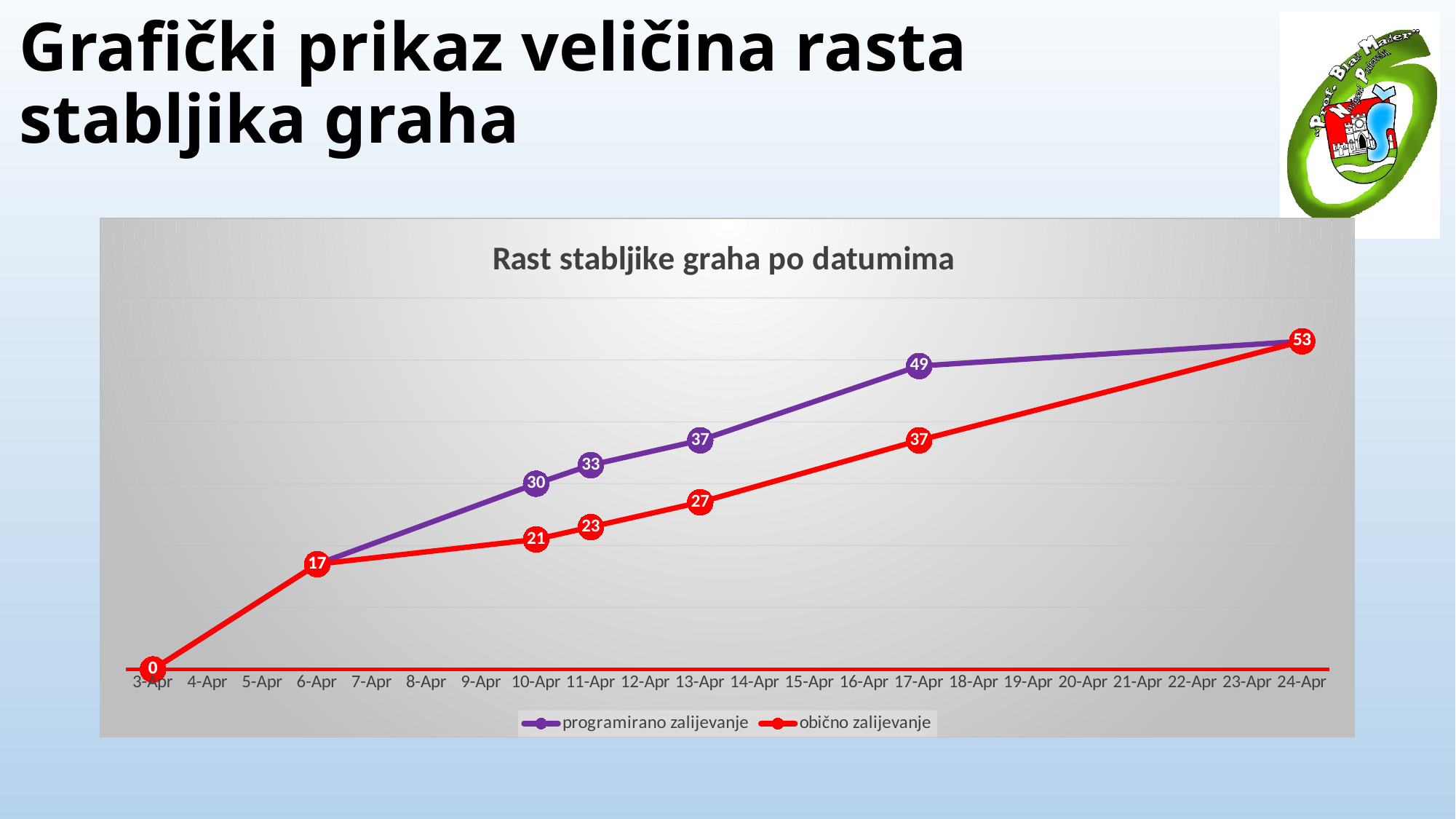
On 13-Apr, which series has the larger value, programirano zalijevanje or obično zalijevanje? programirano zalijevanje Do the values for obično zalijevanje rise or fall from 3-Apr to 24-Apr? rise What is the difference between programirano zalijevanje and obično zalijevanje on 17-Apr? 12 What is the value for programirano zalijevanje on 17-Apr? 49 What is the value for programirano zalijevanje on 10-Apr? 30 What type of chart is shown on the slide? line chart What is the title of the chart? Rast stabljike graha po datumima What is the value for obično zalijevanje on 13-Apr? 27 What is the difference between programirano zalijevanje and obično zalijevanje on 10-Apr? 9 How many series does the legend list? 2 What is the value for obično zalijevanje on 11-Apr? 23 On which date does obično zalijevanje reach its highest value? 24-Apr